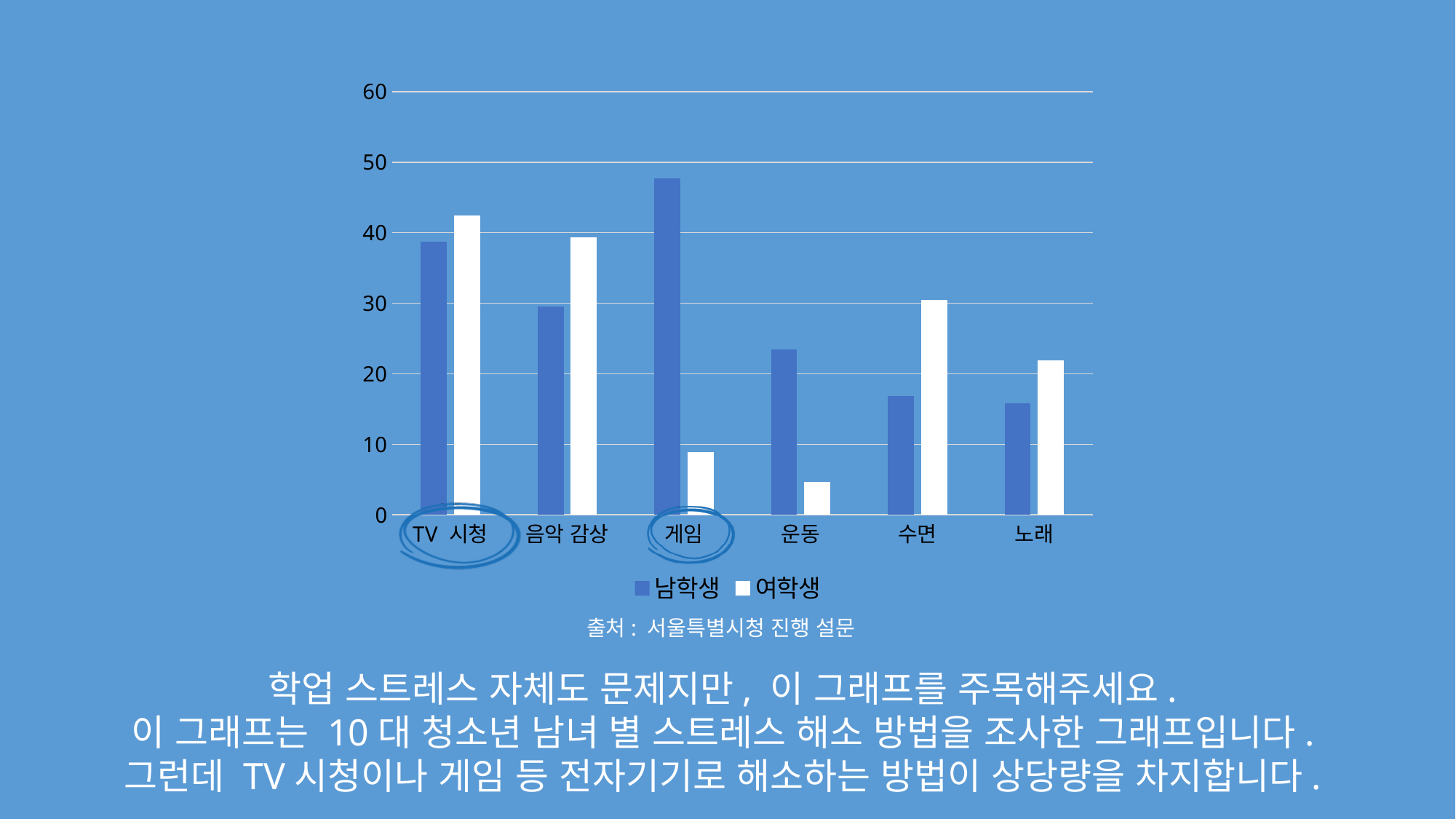
Which category has the lowest value for 여학생? 운동 What are the two series listed in the chart's legend? 남학생, 여학생 For 수면, which series has the larger value, 남학생 or 여학생? 여학생 What kind of chart is shown on the slide? bar chart For 게임, which series has the larger value, 남학생 or 여학생? 남학생 How many categories are shown on the x axis of the chart? 6 How many series does the chart's legend list? 2 Is the value for 남학생 in 게임 greater or less than 40? greater Which category has the highest value for 남학생? 게임 Is the value for 여학생 in 게임 greater or less than 10? less Is the value for 남학생 in 운동 greater or less than 20? greater Which category has the highest value for 여학생? TV 시청